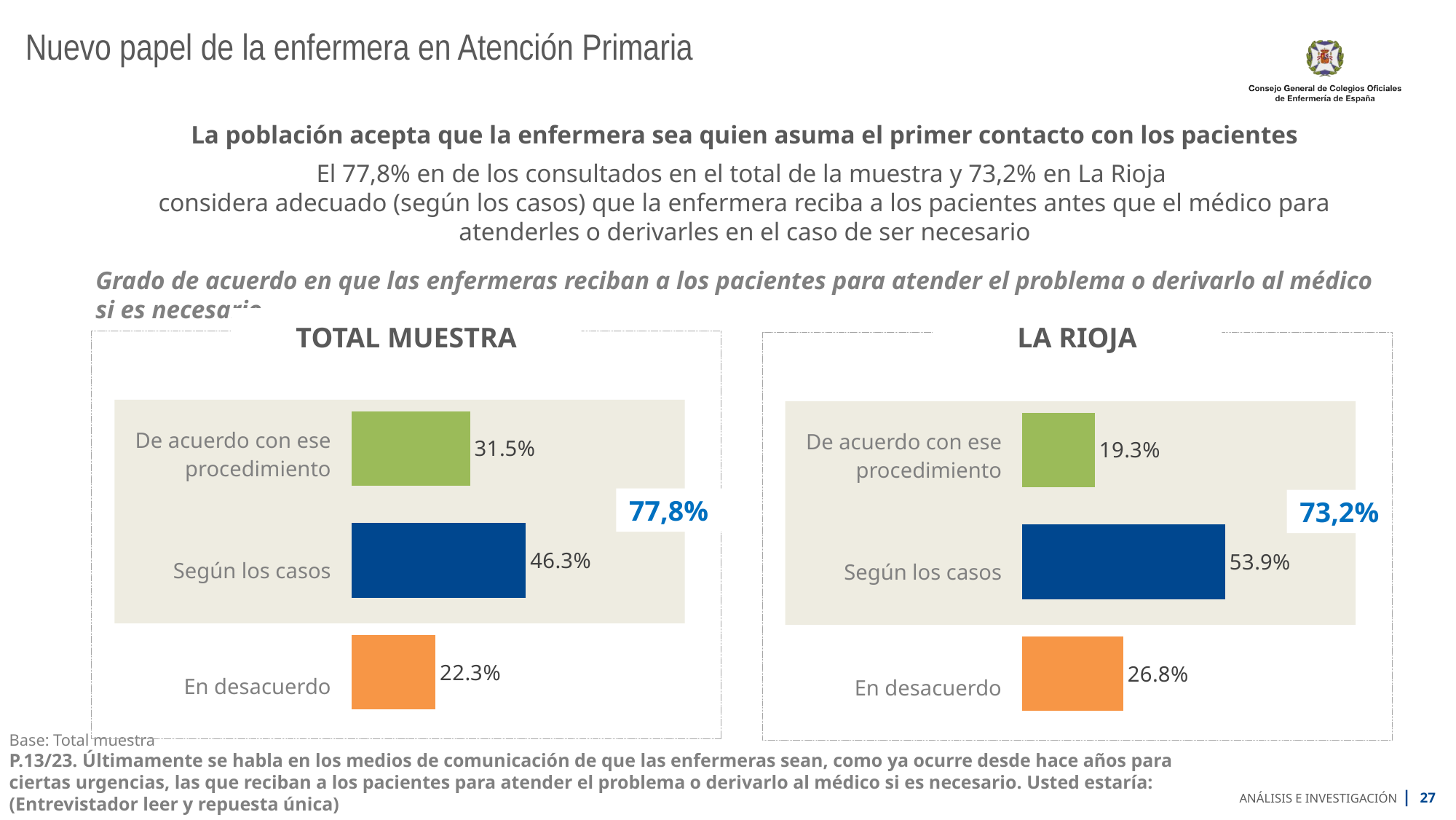
In the TOTAL MUESTRA chart, what is the difference between 'Según los casos' and 'De acuerdo con ese procedimiento'? 14.8% In the LA RIOJA chart, what is the difference between 'Según los casos' and 'En desacuerdo'? 27.1% Which is larger: 'En desacuerdo' in the TOTAL MUESTRA chart or 'En desacuerdo' in the LA RIOJA chart? LA RIOJA In the TOTAL MUESTRA chart, what is the value for 'Según los casos'? 46.3% In the LA RIOJA chart, what is the value for 'En desacuerdo'? 26.8% In the LA RIOJA chart, what is the value for 'De acuerdo con ese procedimiento'? 19.3% What kind of chart is the LA RIOJA chart? Bar chart How many categories does the TOTAL MUESTRA chart show? 3 In the TOTAL MUESTRA chart, which category has the highest value? Según los casos What colour is the 'Según los casos' bar in the LA RIOJA chart? Dark blue In the TOTAL MUESTRA chart, what combined percentage is highlighted for the first two categories? 77,8% In the LA RIOJA chart, which category has the lowest value? De acuerdo con ese procedimiento